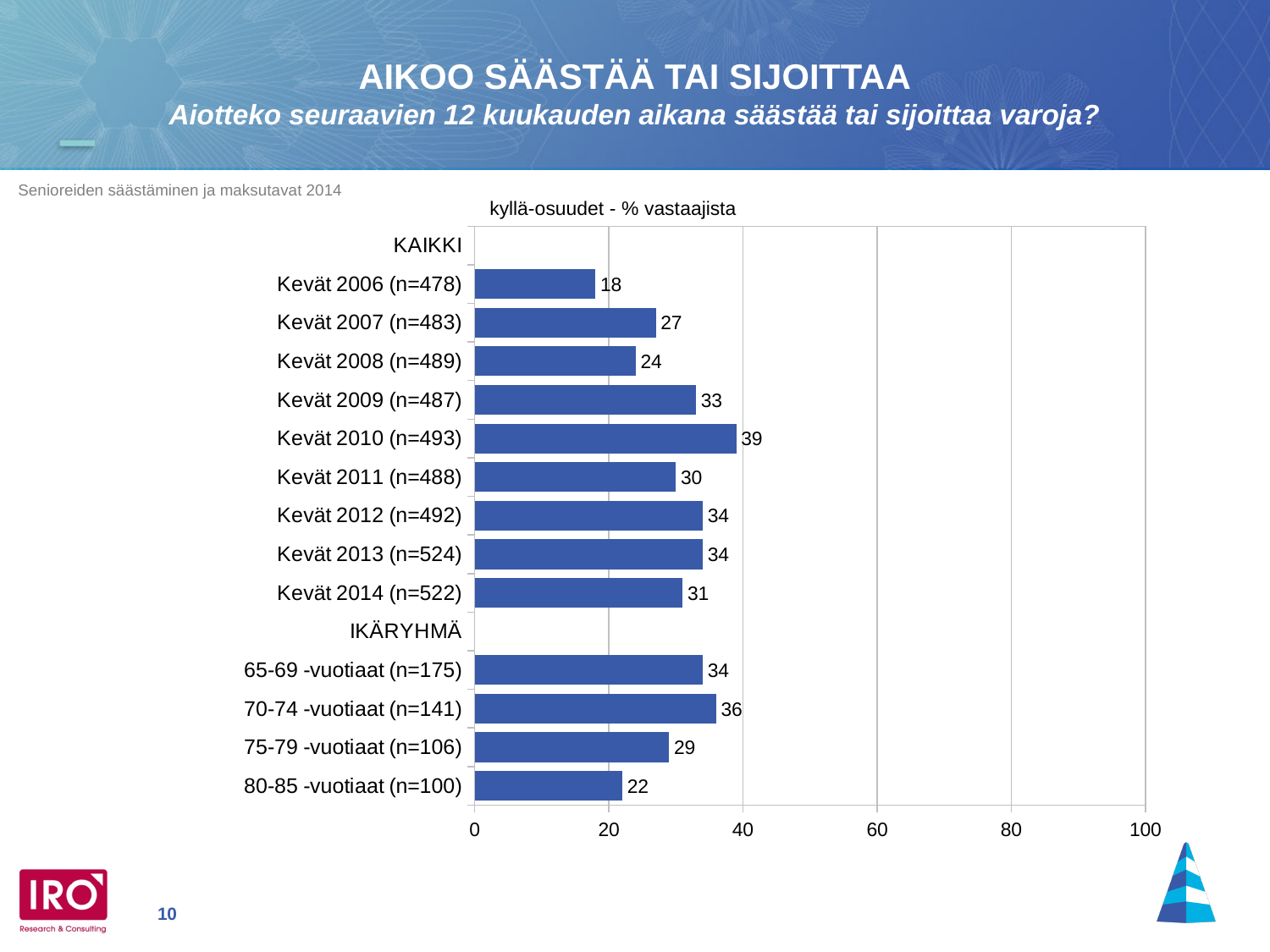
What is the title shown above the chart? kyllä-osuudet - % vastaajista Is the value for Kevät 2009 (n=487) greater or less than 40? less What is the value for Kevät 2010 (n=493)? 39 How many age-group (IKÄRYHMÄ) bars are shown? 4 What is the value for 80-85 -vuotiaat (n=100)? 22 Which category has the lowest value? Kevät 2006 (n=478) Which is larger, the value for 70-74 -vuotiaat (n=141) or 75-79 -vuotiaat (n=106)? 70-74 -vuotiaat (n=141) What kind of chart is shown? bar chart What is the difference between the values for Kevät 2013 (n=524) and Kevät 2014 (n=522)? 3 What is the difference between the values for Kevät 2010 (n=493) and Kevät 2006 (n=478)? 21 What is the value for Kevät 2014 (n=522)? 31 Which category has the highest value? Kevät 2010 (n=493)